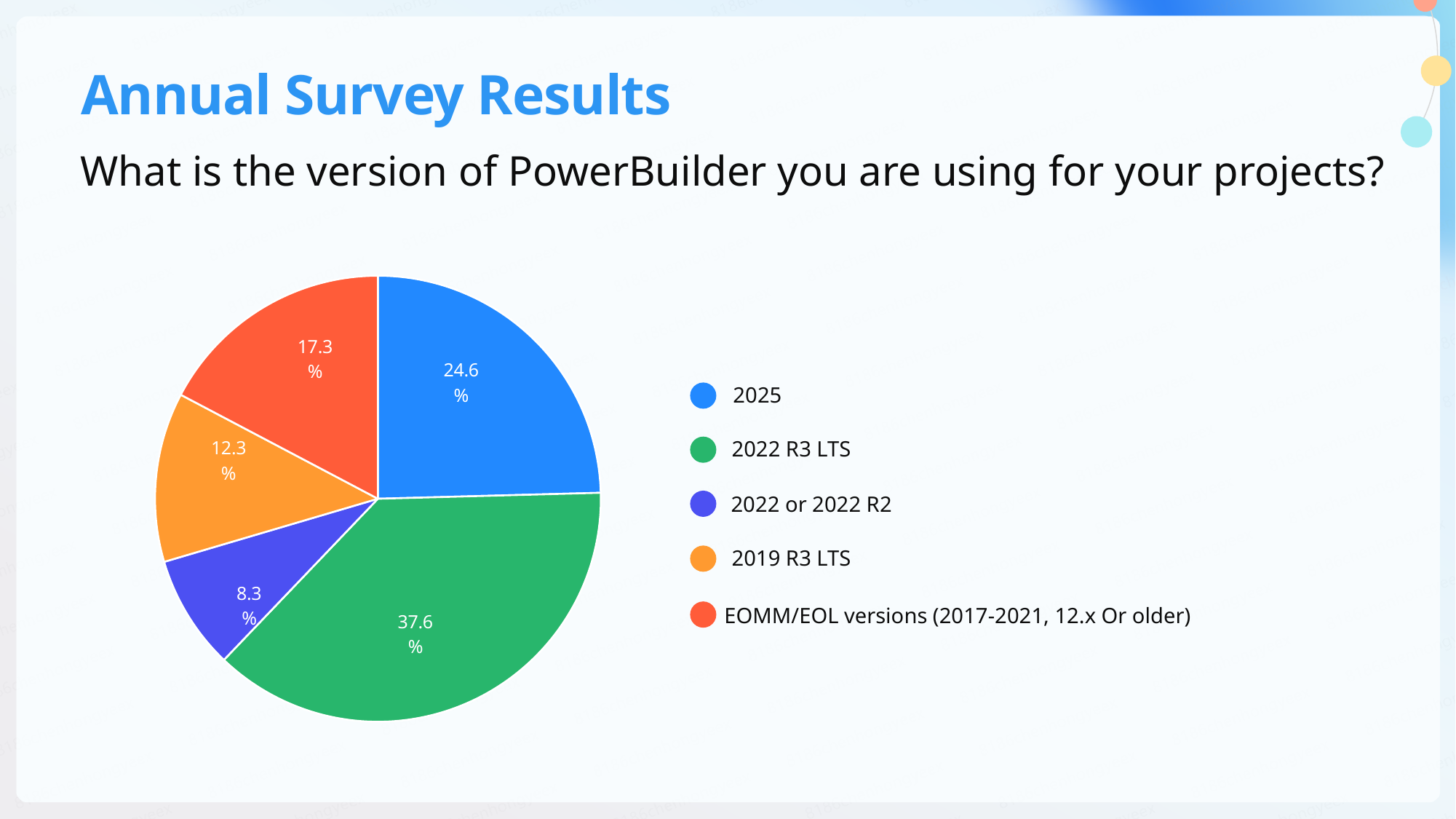
What share of respondents use 2022 or 2022 R2? 8.3% What share of respondents use 2019 R3 LTS? 12.3% What is the difference in percentage points between the 2022 R3 LTS share and the 2025 share? 13 percentage points Which version has the smallest share of the pie? 2022 or 2022 R2 Which version has the largest share of the pie? 2022 R3 LTS What kind of chart is shown on the slide? Pie chart What colour is the slice for 2019 R3 LTS? Orange What share of respondents use 2022 R3 LTS? 37.6% What share of respondents use EOMM/EOL versions (2017-2021, 12.x Or older)? 17.3% Which has a larger share: 2019 R3 LTS or EOMM/EOL versions (2017-2021, 12.x Or older)? EOMM/EOL versions (2017-2021, 12.x Or older) How many categories does the pie chart show? 5 What share of respondents use PowerBuilder 2025? 24.6%